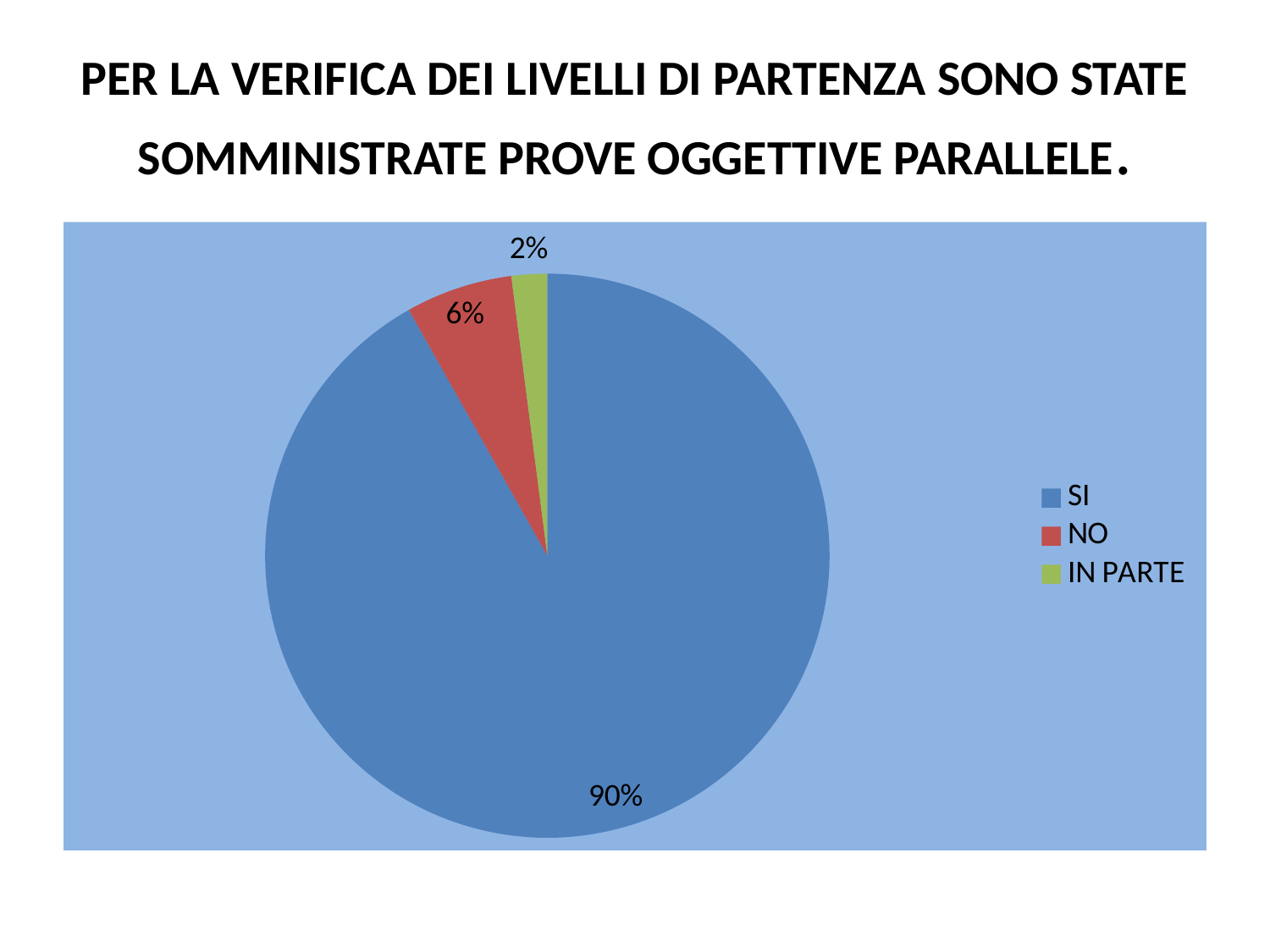
How many entries does the legend list? 3 How many categories does the pie chart show? 3 What is the difference in percentage points between the SI slice and the NO slice? 84 What percentage of the pie is labelled SI? 90% Which category has the largest slice of the pie? SI Which slice is larger, NO or IN PARTE? NO Which category has the smallest slice of the pie? IN PARTE What is the difference in percentage points between the NO slice and the IN PARTE slice? 4 What percentage of the pie is labelled NO? 6% What kind of chart is shown on the slide? pie chart What percentage of the pie is labelled IN PARTE? 2% What colour is the slice for NO? red